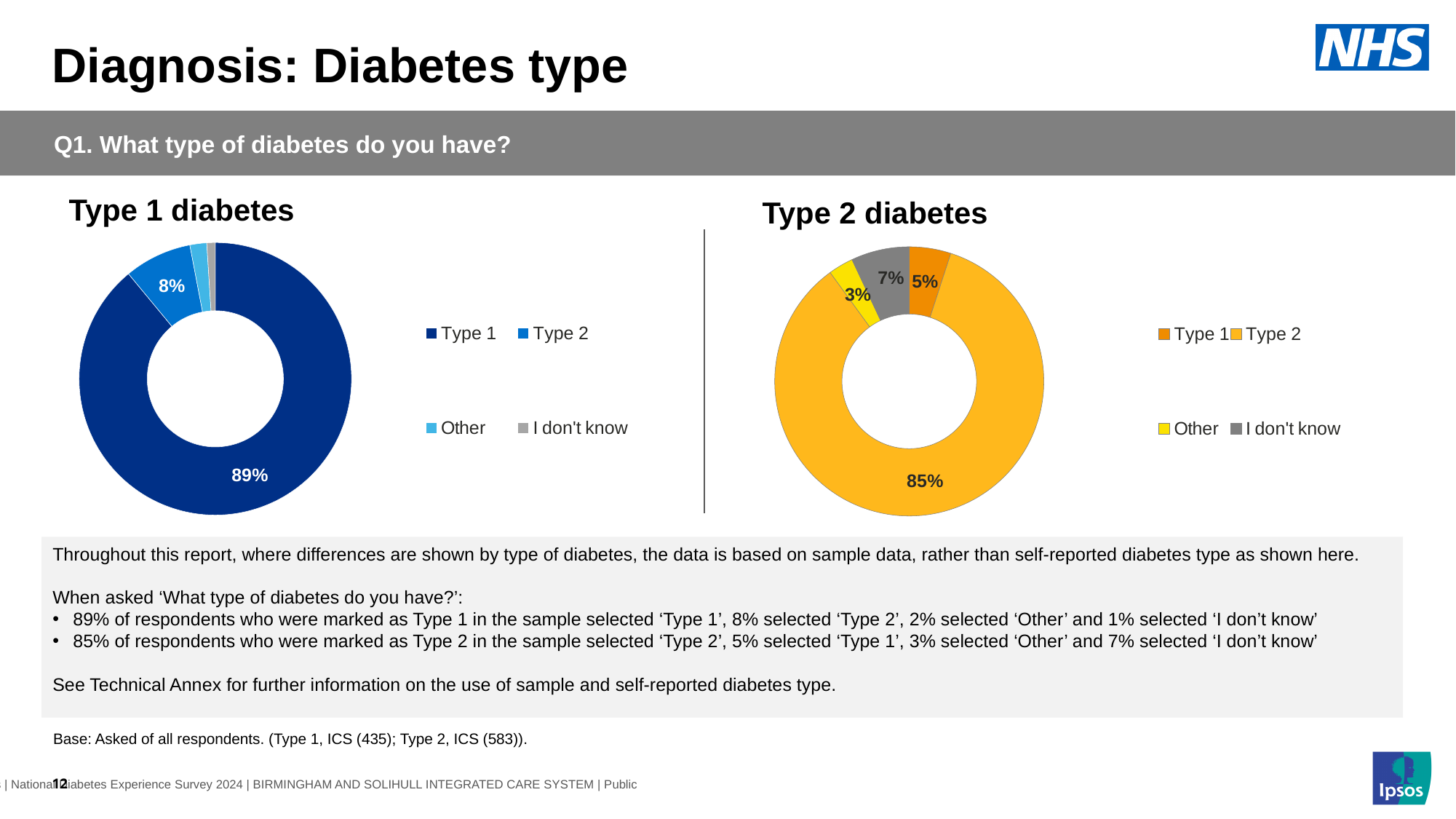
In the Type 1 diabetes chart, which category has the largest slice? Type 1 How many categories does the legend of the Type 2 diabetes chart list? 4 In the Type 1 diabetes chart, what share of respondents selected 'Type 1'? 89% In the Type 2 diabetes chart, what share of respondents selected 'Other'? 3% In the Type 2 diabetes chart, what share of respondents selected 'Type 1'? 5% In the Type 2 diabetes chart, which category has the smallest slice? Other In the Type 1 diabetes chart, which is larger: the 'Type 1' slice or the 'Type 2' slice? Type 1 In the Type 2 diabetes chart, how many percentage points larger is the 'I don't know' slice than the 'Other' slice? 4 percentage points In the Type 1 diabetes chart, what share of respondents selected 'Type 2'? 8% In the Type 2 diabetes chart, what share of respondents selected 'Type 2'? 85% In the Type 2 diabetes chart, what share of respondents selected 'I don't know'? 7% What kind of chart is used for the Type 1 diabetes data? Doughnut (pie) chart